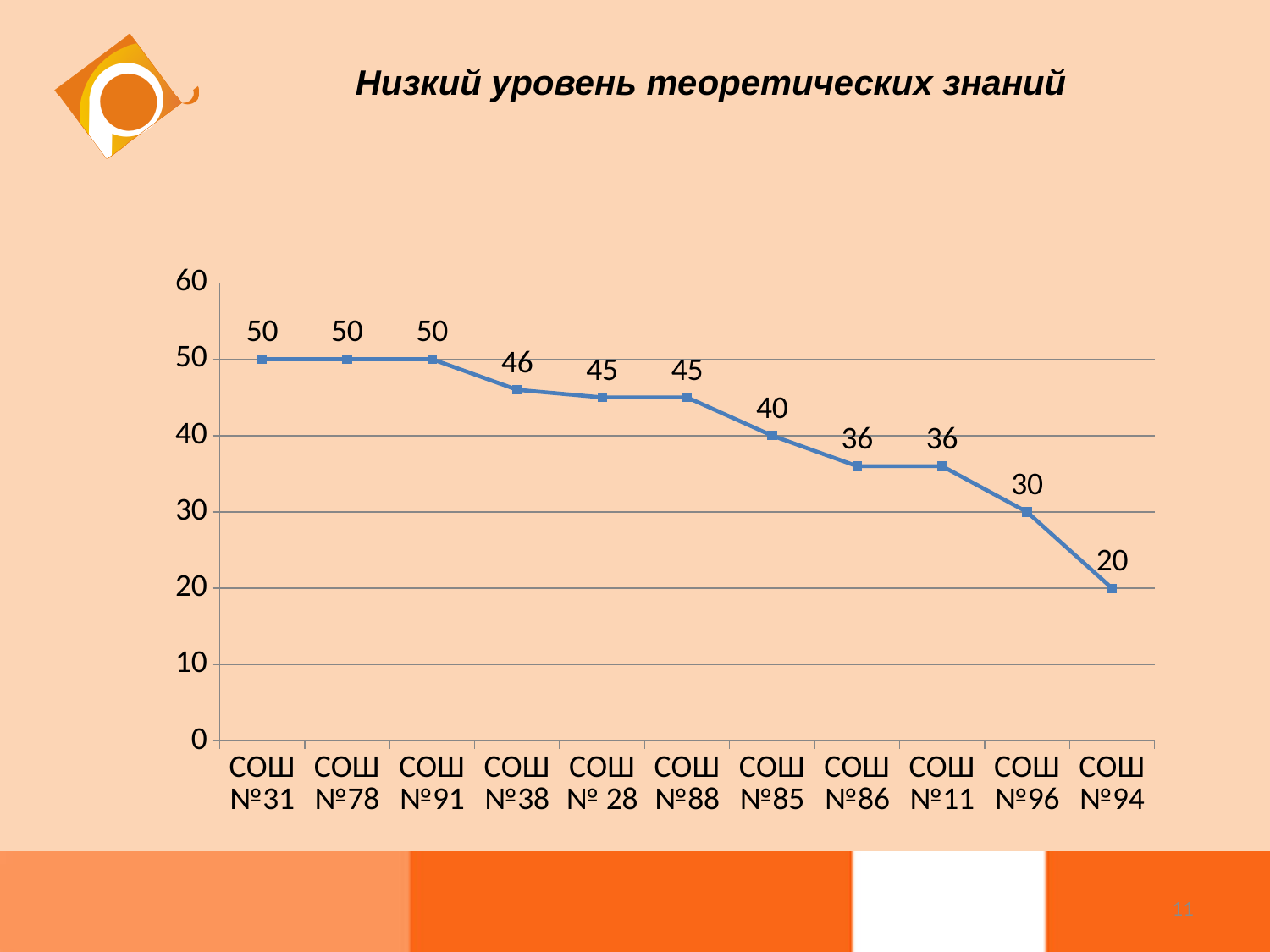
Do the values rise or fall from left to right along the x axis? fall What is the value for СОШ №96? 30 Is the value for СОШ №85 greater or less than 30? greater What kind of chart is shown on the slide? line chart Which is larger, the value for СОШ №88 or the value for СОШ №11? СОШ №88 What is the difference between the values for СОШ №38 and СОШ №86? 10 What is the difference between the values for СОШ №31 and СОШ №94? 30 What is the value for СОШ №94? 20 What is the value for СОШ №85? 40 Which category has the lowest value? СОШ №94 What is the value for СОШ №38? 46 How many categories are shown on the x axis? 11